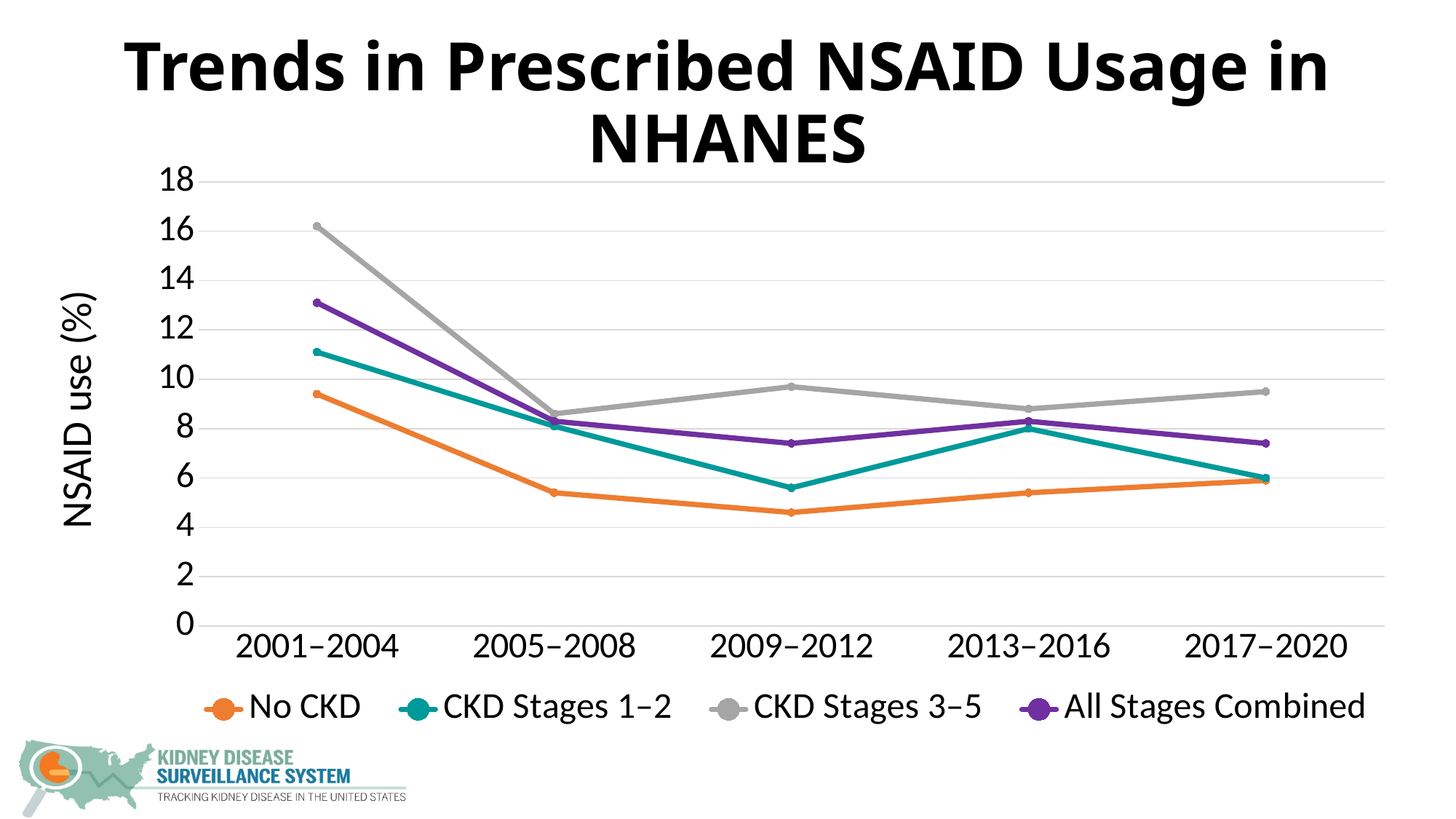
For the CKD Stages 3–5 series, which period has the highest value? 2001–2004 Is the value for All Stages Combined in 2001–2004 greater or less than 12? greater How many series does the legend list? 4 What is the label on the y axis? NSAID use (%) What kind of chart is shown on the slide? line chart How many survey periods are shown on the x axis? 5 Is the value for CKD Stages 3–5 in 2001–2004 greater or less than 14? greater Which series has the highest NSAID use in 2001–2004? CKD Stages 3–5 Which series has the lowest NSAID use in 2001–2004? No CKD In 2013–2016, which is larger: the value for CKD Stages 1–2 or the value for No CKD? CKD Stages 1–2 Does the No CKD series rise or fall from 2001–2004 to 2009–2012? fall Is the value for No CKD in 2009–2012 greater or less than 6? less